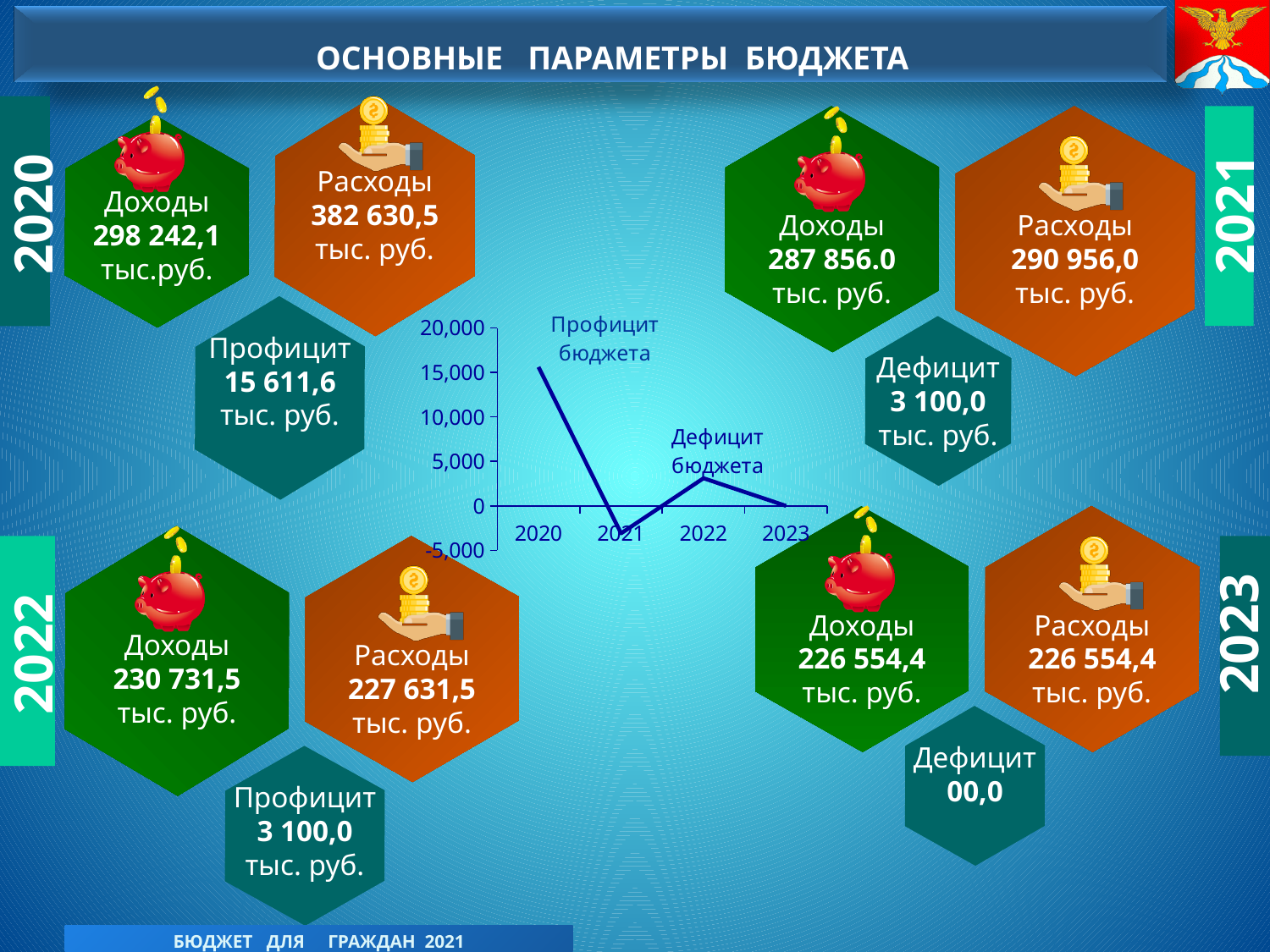
What kind of chart is shown in the centre of the slide? line chart What is the highest tick shown on the y axis of the line chart? 20,000 Is the value for 2021 on the line chart greater or less than 0? less Does the line rise or fall from 2020 to 2021? fall What two annotations are written next to the line on the chart? Профицит бюджета and Дефицит бюджета Is the value for 2020 on the line chart greater or less than 10,000? greater How many years are plotted along the x axis of the line chart? 4 Is the value for 2022 on the line chart greater or less than 5,000? less On the line chart, which year has the larger value, 2020 or 2022? 2020 Which year has the lowest value on the line chart? 2021 Which year has the highest value on the line chart? 2020